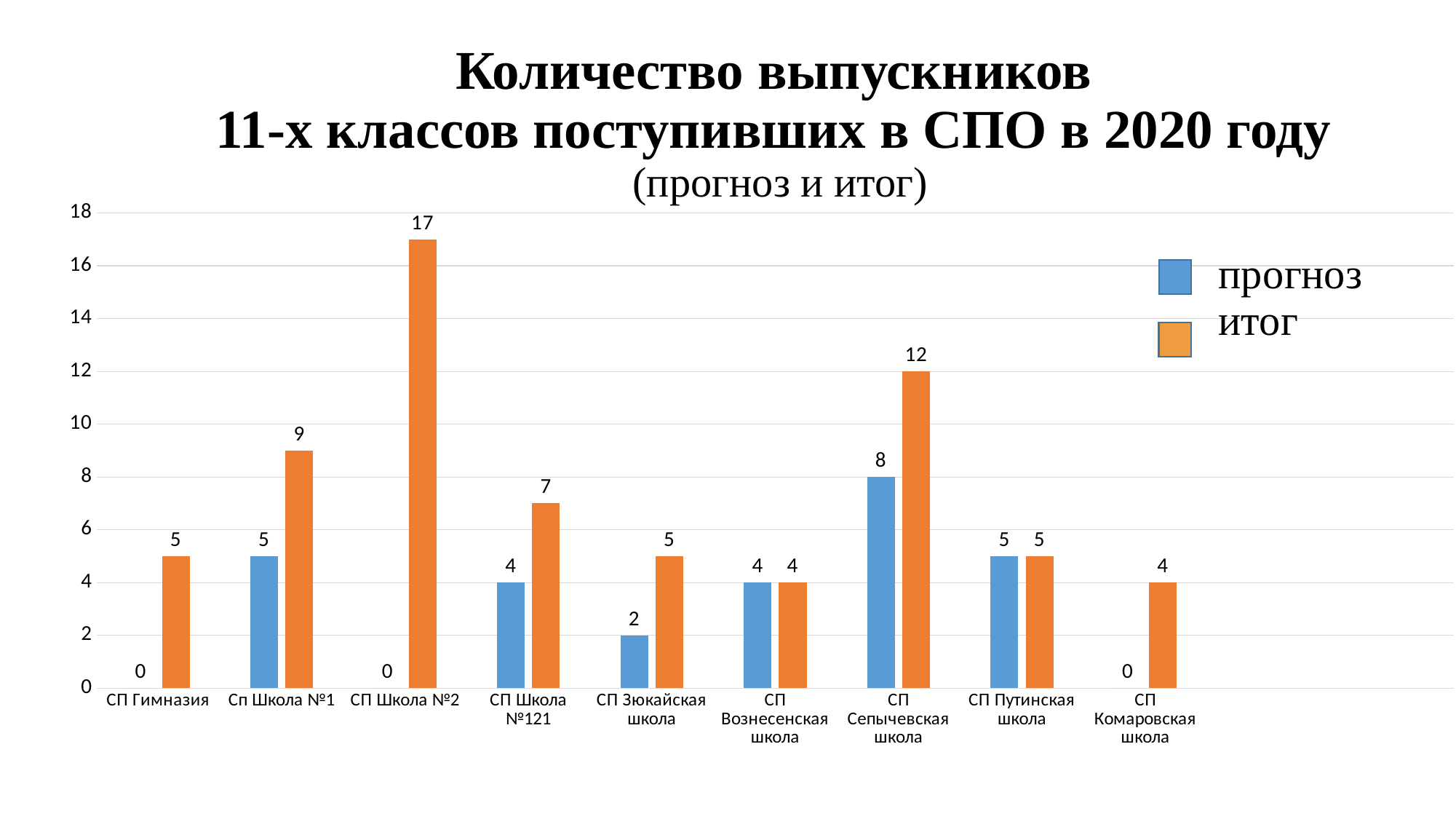
What is the итог value for СП Комаровская школа? 4 What is the прогноз value for СП Сепычевская школа? 8 What is the итог value for СП Школа №2? 17 What kind of chart is shown on the slide? bar chart Which colour represents the итог series in the legend? orange Which category has the highest итог value? СП Школа №2 What is the difference between the итог and прогноз values for СП Сепычевская школа? 4 What is the difference between the итог values for СП Школа №2 and Сп Школа №1? 8 Which is larger for СП Школа №121: the прогноз value or the итог value? итог How many categories are shown on the x axis? 9 Which category has the lowest прогноз value among those with a non-zero прогноз? СП Зюкайская школа How many series does the legend list? 2